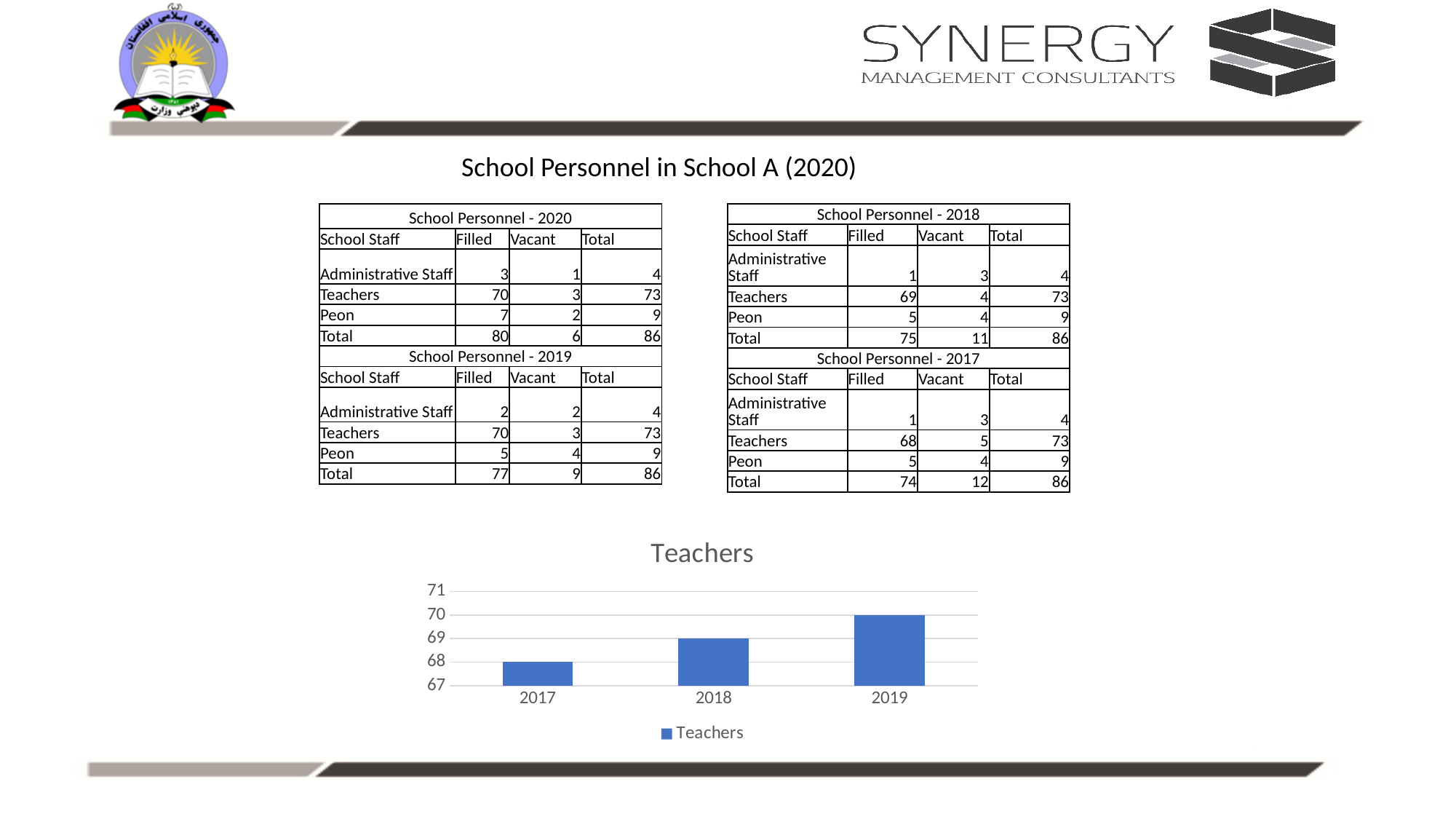
What is the value for 2018 in the Teachers chart? 69 How many series does the legend of the Teachers chart list? 1 Which year has the lowest value in the Teachers chart? 2017 Which year has the highest value in the Teachers chart? 2019 Which is larger in the Teachers chart, the value for 2018 or the value for 2017? 2018 How many years are shown on the x axis of the Teachers chart? 3 What is the value for 2019 in the Teachers chart? 70 What is the value for 2017 in the Teachers chart? 68 Do the values in the Teachers chart rise or fall from 2017 to 2019? rise What type of chart is shown on the slide? bar chart What is the title of the chart? Teachers What is the difference between the values for 2019 and 2017 in the Teachers chart? 2